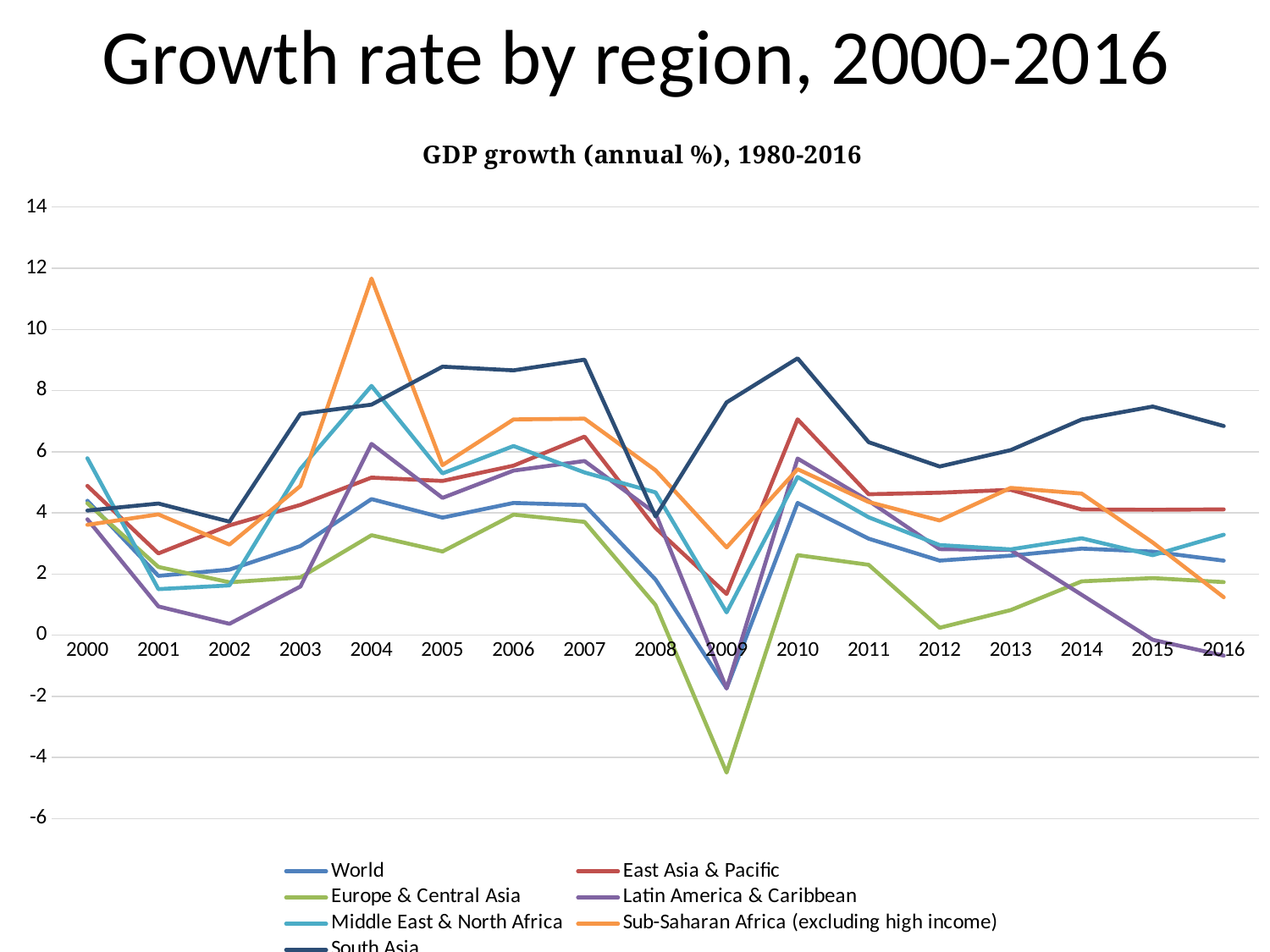
How many years are plotted along the x axis? 17 How many series does the legend list? 7 Is the value for Sub-Saharan Africa (excluding high income) in 2004 greater or less than 10? greater What kind of chart is shown on the slide? line chart In which year does Sub-Saharan Africa (excluding high income) reach its highest growth rate? 2004 Does the Latin America & Caribbean line rise or fall from 2013 to 2016? fall Which region has the lowest growth rate in 2009? Europe & Central Asia In 2016, which is larger: the value for South Asia or the value for World? South Asia Is the value for Europe & Central Asia in 2009 greater or less than -2? less In which year does Europe & Central Asia reach its lowest growth rate? 2009 Is the value for South Asia in 2007 greater or less than 8? greater Which region has the highest growth rate in 2004? Sub-Saharan Africa (excluding high income)